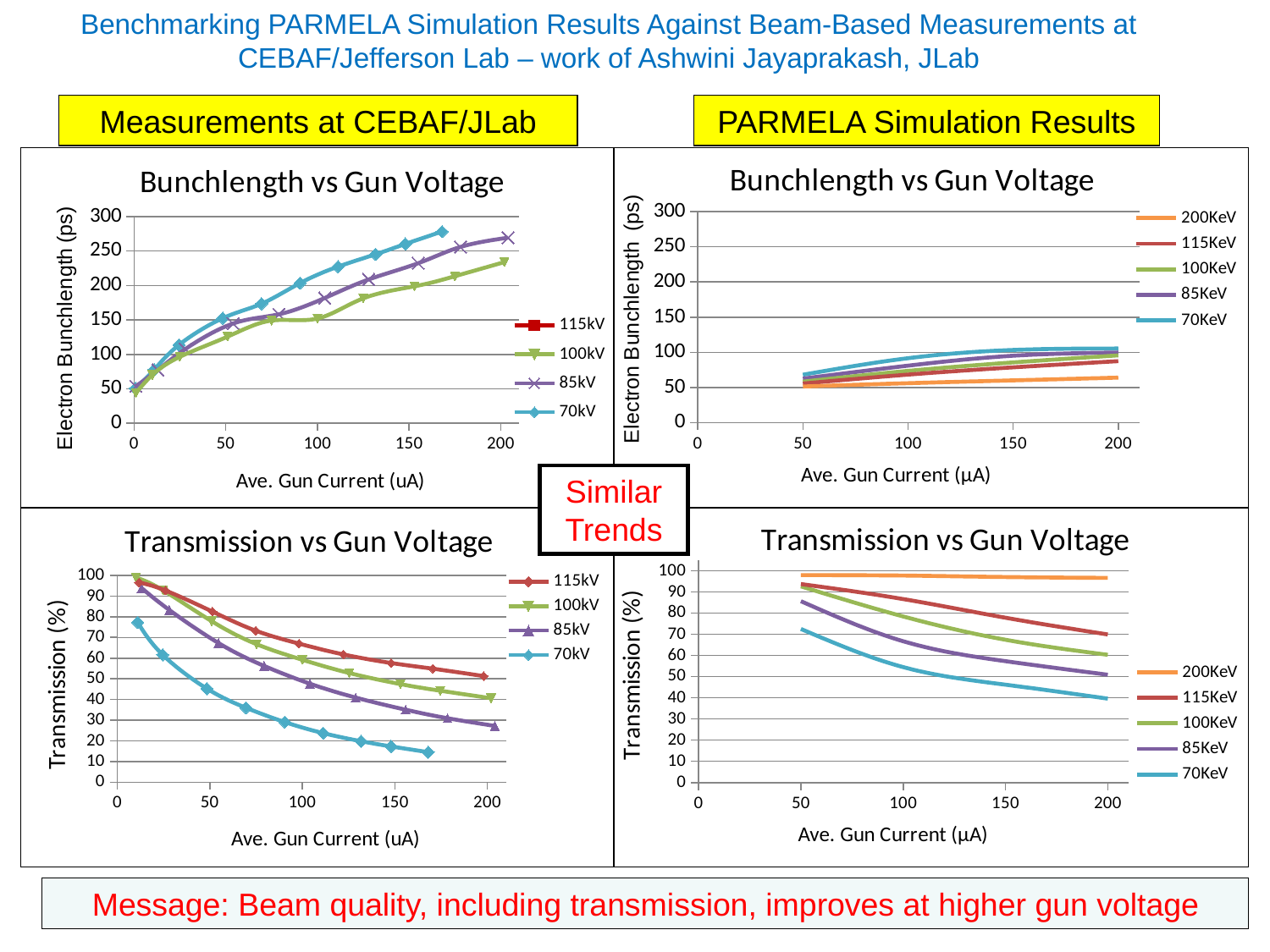
In the top-left 'Bunchlength vs Gun Voltage' measurement chart, is the 70kV value at 150 uA greater or less than 200? greater In the bottom-left 'Transmission vs Gun Voltage' measurement chart, do the transmission values rise or fall as gun current increases? fall What is the x-axis label of the bottom-right 'Transmission vs Gun Voltage' simulation chart? Ave. Gun Current (µA) How many series does the legend list in the top-right 'Bunchlength vs Gun Voltage' PARMELA simulation chart? 5 In the bottom-left 'Transmission vs Gun Voltage' measurement chart, which series has the higher value at 100 uA: 115kV or 70kV? 115kV What type of chart is the top-left 'Bunchlength vs Gun Voltage' chart under 'Measurements at CEBAF/JLab'? line chart In the top-right 'Bunchlength vs Gun Voltage' simulation chart, is the 200KeV value at 200 µA greater or less than 100? less Which series is shown in orange in the top-right 'Bunchlength vs Gun Voltage' simulation chart? 200KeV In the bottom-right 'Transmission vs Gun Voltage' simulation chart, is the 200KeV value at 200 µA greater or less than 90? greater How many series does the legend list in the top-left 'Bunchlength vs Gun Voltage' measurement chart? 4 In the top-right 'Bunchlength vs Gun Voltage' simulation chart, do the bunchlength values rise or fall as gun current increases? rise